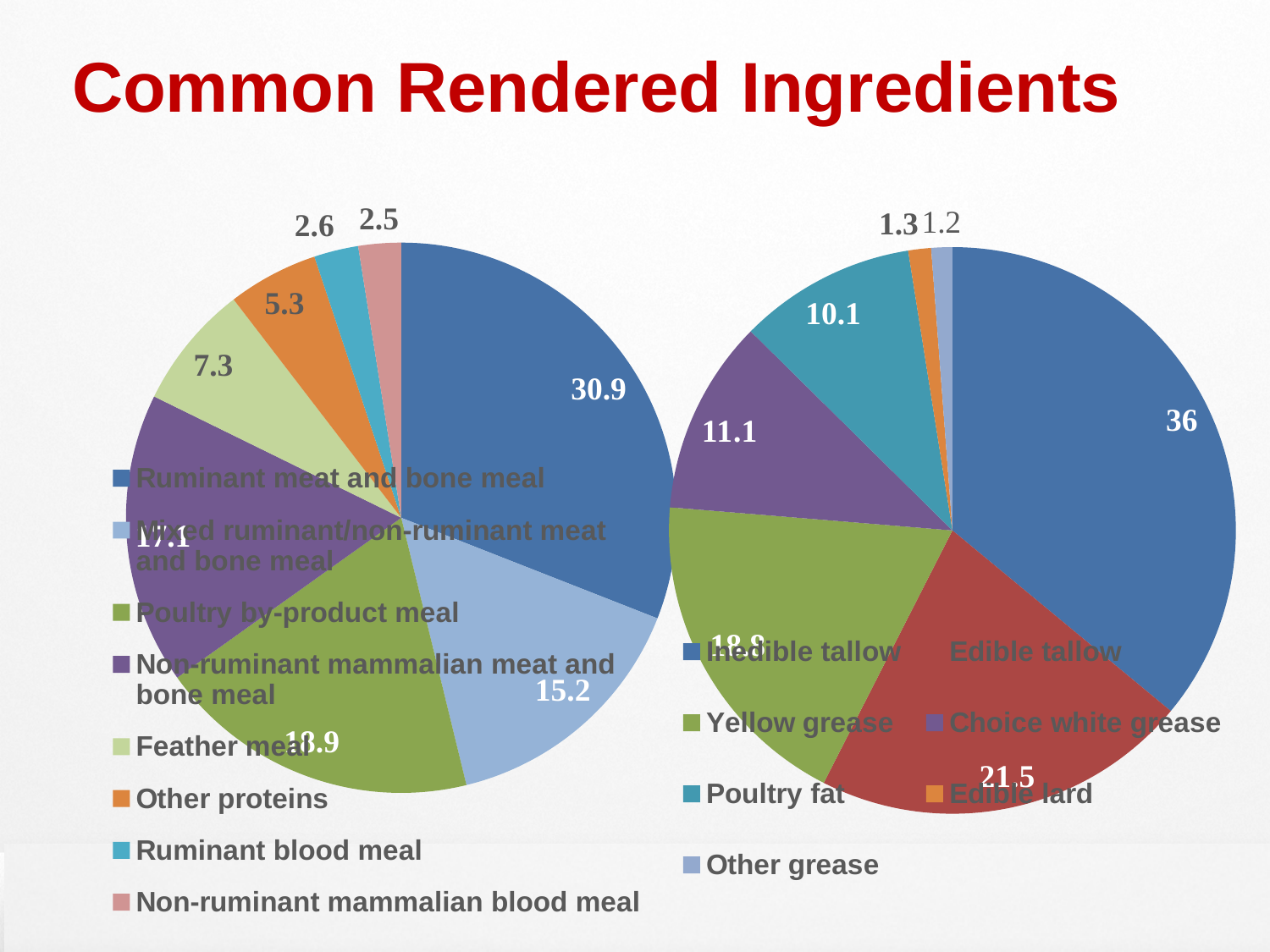
How many categories does the legend of the right pie chart list? 7 On the left pie chart, which is larger: Poultry by-product meal or Mixed ruminant/non-ruminant meat and bone meal? Poultry by-product meal On the right pie chart, what is the value for Inedible tallow? 36 On the right pie chart, what is the difference between Inedible tallow and Edible tallow? 14.5 On the right pie chart, which category has the smallest slice? Other grease On the left pie chart, what is the value for Feather meal? 7.3 What is the title of the slide? Common Rendered Ingredients On the left pie chart, which category has the largest slice? Ruminant meat and bone meal On the right pie chart, what is the value for Poultry fat? 10.1 What type of chart is used on the left side of the slide? Pie chart On the left pie chart, what is the value for Ruminant meat and bone meal? 30.9 How many categories does the legend of the left pie chart list? 8